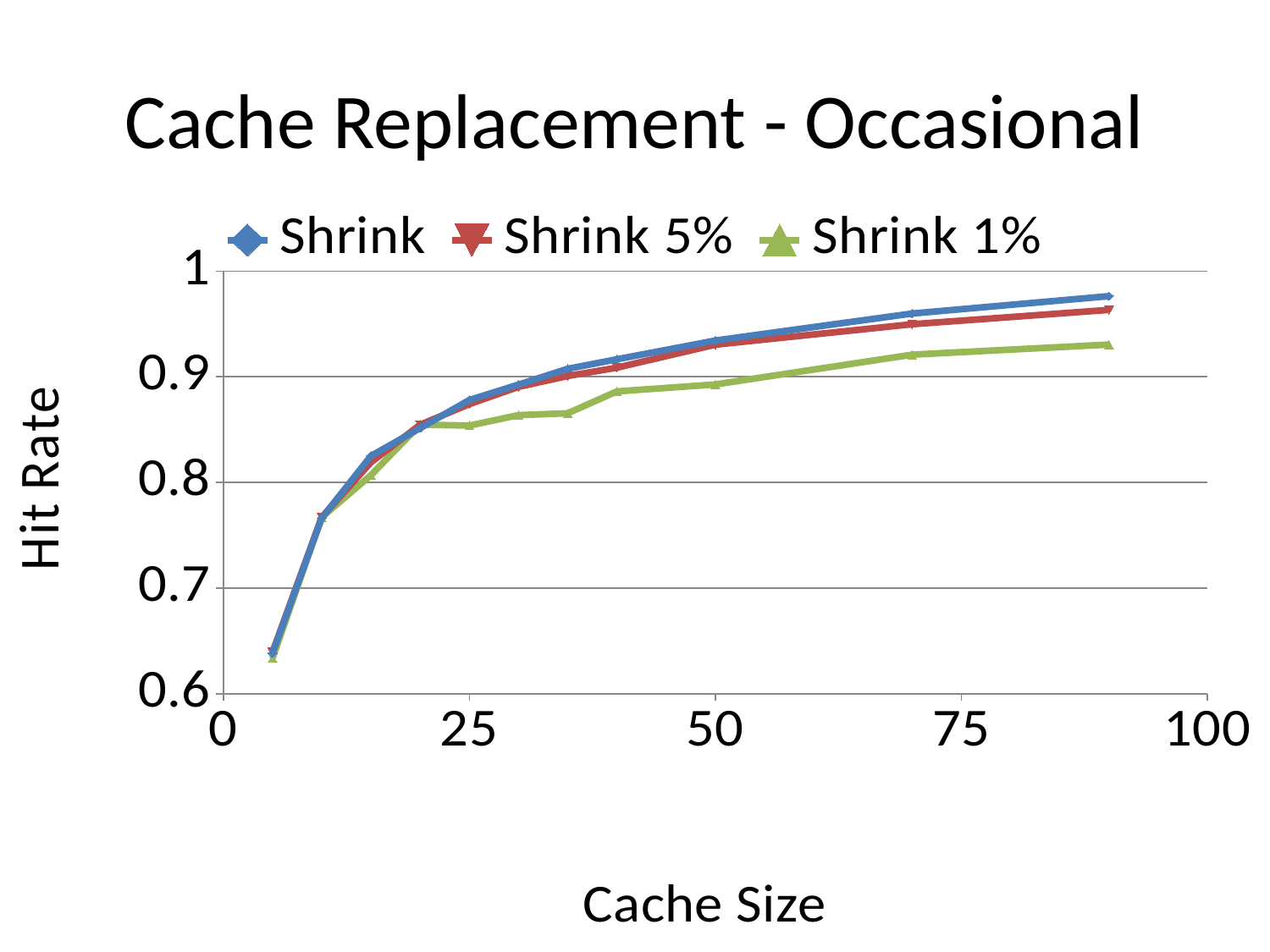
Is the hit rate for Shrink at cache size 5 greater or less than 0.7? less Is the hit rate for Shrink 5% at cache size 50 greater or less than 0.9? greater Is the hit rate for Shrink 1% at cache size 90 greater or less than 0.9? greater What kind of chart is shown on the slide? line chart What is the title of the chart? Cache Replacement - Occasional At cache size 70, which series has the higher hit rate, Shrink or Shrink 1%? Shrink How many data points are plotted for the Shrink 1% series? 11 Which series has the lowest hit rate at cache size 90? Shrink 1% Does the hit rate for the Shrink series rise or fall as cache size increases? rise What is the label of the y axis? Hit Rate How many series does the legend list? 3